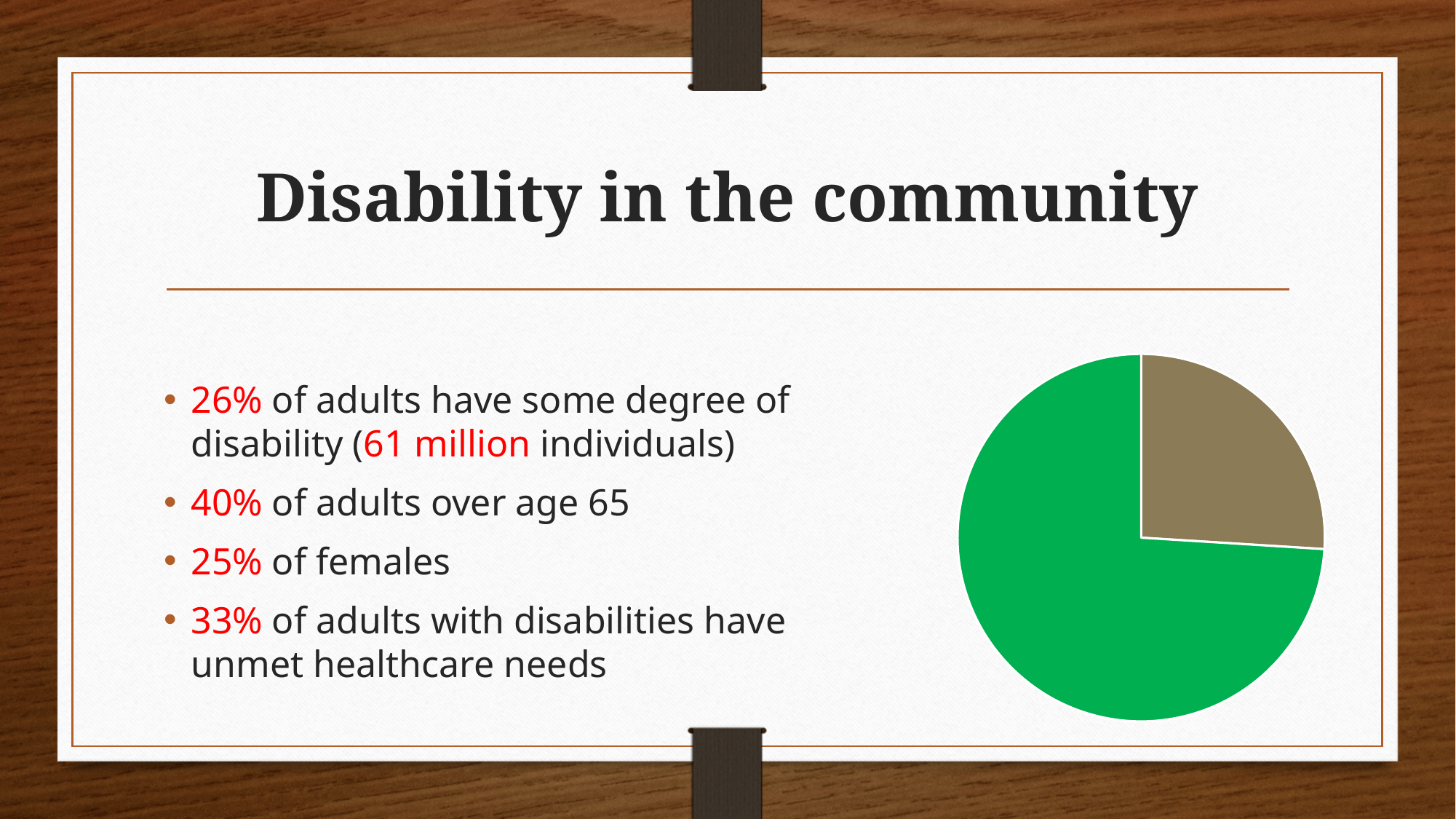
How many slices does the pie chart have? 2 What kind of chart is shown on the right side of the slide? pie chart Does the pie chart display a legend? No Does the pie chart have a title printed above it? No Which slice of the pie chart is larger, the green one or the brown one? the green one What colour is the smallest slice of the pie chart? brown Does the green slice cover more or less than half of the pie chart? more Does the brown slice cover more or less than half of the pie chart? less What colour is the largest slice of the pie chart? green